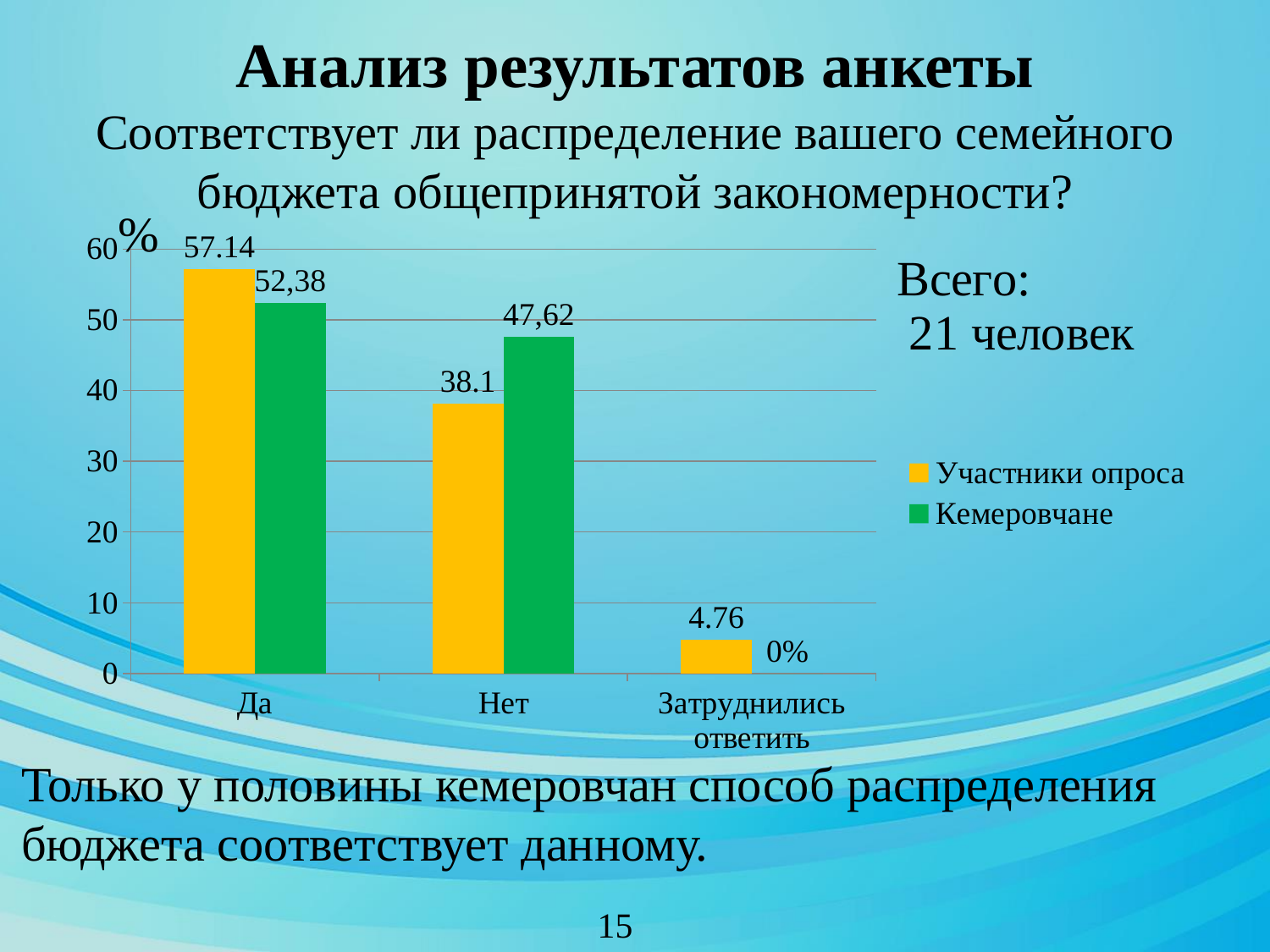
How many categories are shown on the x axis? 3 What is the value for Участники опроса in the Да category? 57.14 What is the difference between the Участники опроса values for Да and Нет? 19.04 Which colour represents the Кемеровчане series? green How many series does the legend list? 2 What is the value for Кемеровчане in the Затруднились ответить category? 0% Which category has the lowest value for Участники опроса? Затруднились ответить In the Нет category, which series has the larger value, Участники опроса or Кемеровчане? Кемеровчане What is the value for Участники опроса in the Затруднились ответить category? 4.76 What kind of chart is shown on the slide? bar chart Which category has the highest value for Кемеровчане? Да What is the value for Кемеровчане in the Нет category? 47,62